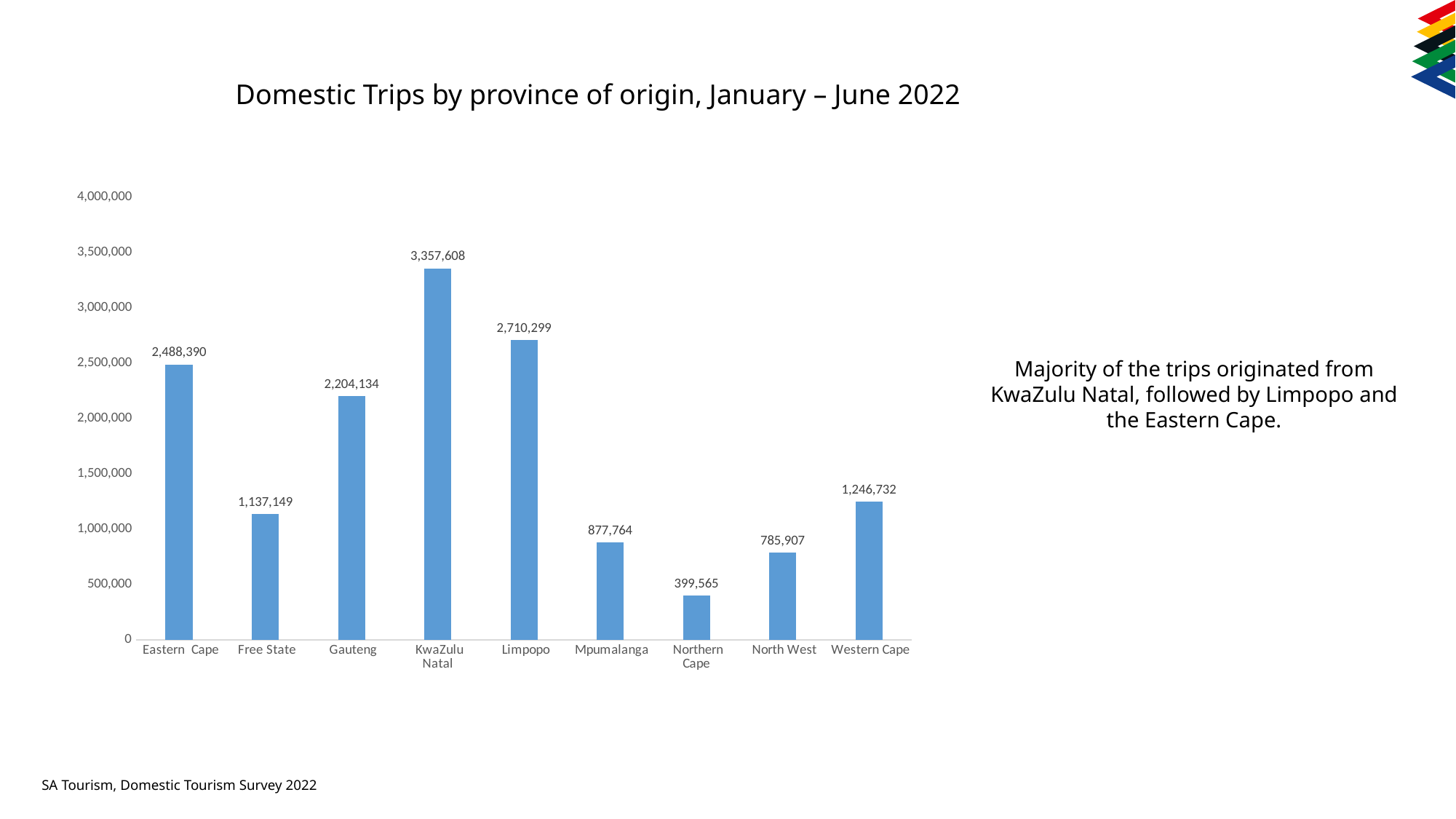
Which province has the lowest number of domestic trips? Northern Cape Is the value for Western Cape greater or less than 1,000,000? greater What is the value shown for Northern Cape? 399,565 How many provinces are shown on the chart? 9 How many domestic trips originated from KwaZulu Natal? 3,357,608 What kind of chart is shown on the slide? Bar chart What is the title of the chart? Domestic Trips by province of origin, January – June 2022 How many domestic trips originated from Gauteng? 2,204,134 Which has more domestic trips, Mpumalanga or North West? Mpumalanga What is the difference between the values for Eastern Cape and Gauteng? 284,256 Which province has the highest number of domestic trips? KwaZulu Natal What is the difference between the values for KwaZulu Natal and Limpopo? 647,309